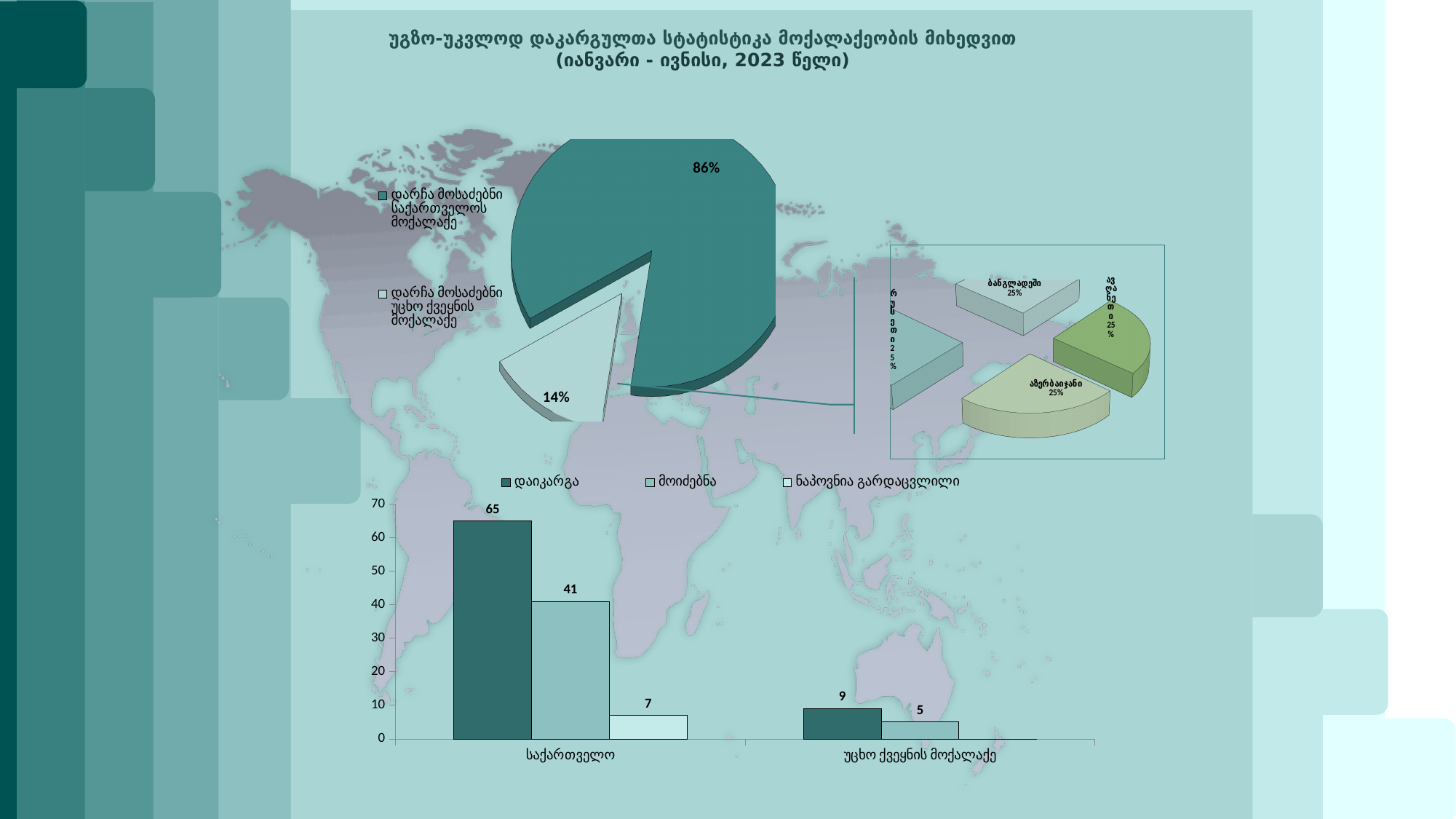
In the bar chart at the bottom, what is the value of დაიკარგა for უცხო ქვეყნის მოქალაქე? 9 In the large pie chart, how many slices are there? 2 In the bar chart at the bottom, how many series does the legend list? 3 In the bar chart at the bottom, what is the value of დაიკარგა for საქართველო? 65 In the large pie chart, what share is shown for the slice labelled დარჩა მოსაძებნი საქართველოს მოქალაქე? 86% In the bar chart at the bottom, which series has the highest value for საქართველო? დაიკარგა In the bar chart at the bottom, what is the value of ნაპოვნია გარდაცვლილი for საქართველო? 7 In the bar chart at the bottom, what is the value of მოიძებნა for უცხო ქვეყნის მოქალაქე? 5 In the bar chart at the bottom, what is the value of მოიძებნა for საქართველო? 41 In the large pie chart, what share is shown for the slice labelled დარჩა მოსაძებნი უცხო ქვეყნის მოქალაქე? 14% In the bar chart at the bottom, what is the difference between დაიკარგა and მოიძებნა for საქართველო? 24 In the small pie chart on the right, what share is shown for ბანგლადეში? 25%